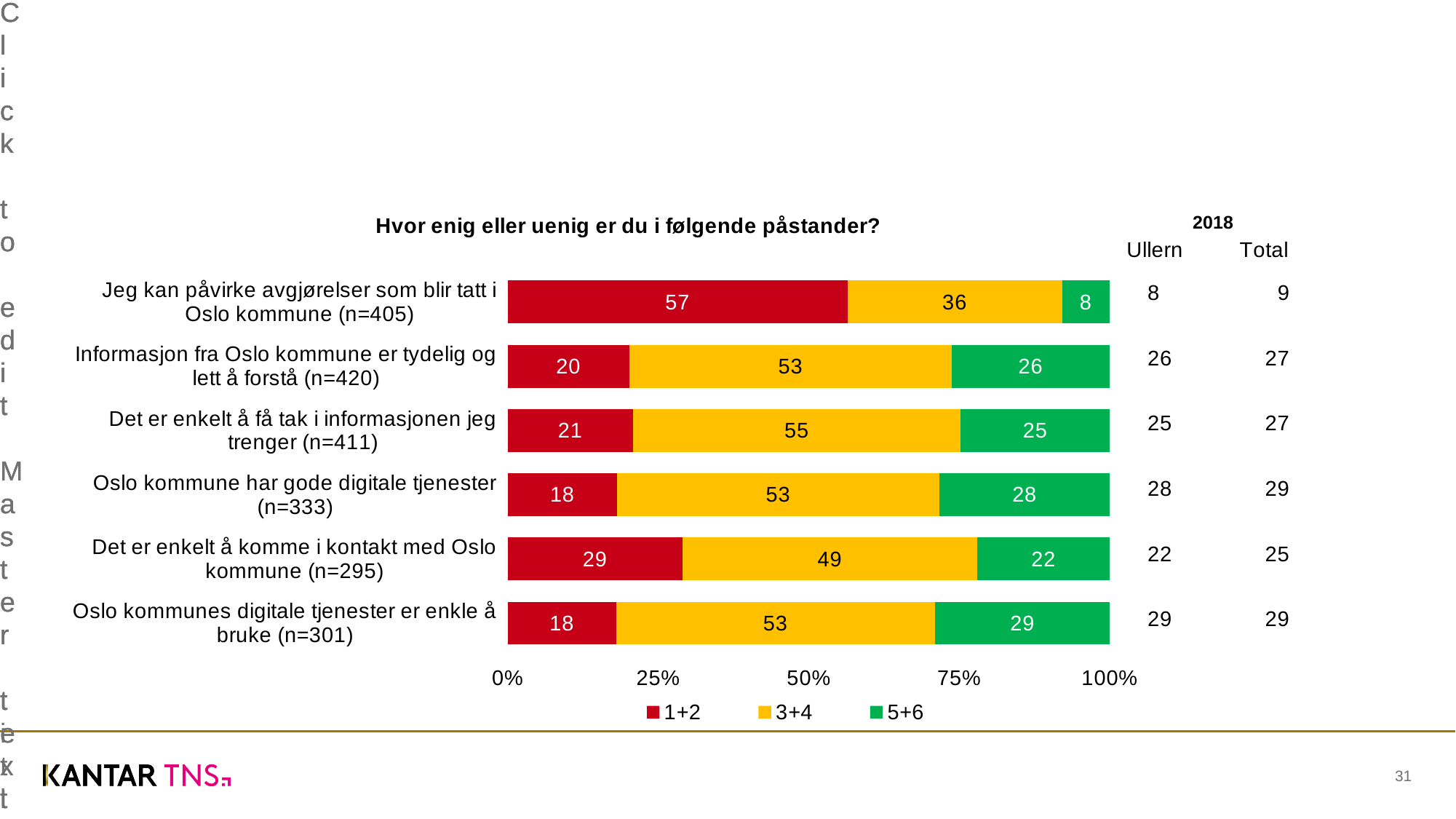
Which statement has the lowest 5+6 value? Jeg kan påvirke avgjørelser som blir tatt i Oslo kommune (n=405) Which is larger: the 5+6 value for "Informasjon fra Oslo kommune er tydelig og lett å forstå (n=420)" or the 5+6 value for "Det er enkelt å komme i kontakt med Oslo kommune (n=295)"? Informasjon fra Oslo kommune er tydelig og lett å forstå (n=420) What is the value of the 5+6 segment for "Oslo kommunes digitale tjenester er enkle å bruke (n=301)"? 29 What kind of chart is shown on the slide? Stacked bar chart What is the value of the 3+4 segment for "Det er enkelt å få tak i informasjonen jeg trenger (n=411)"? 55 What is the title of the chart? Hvor enig eller uenig er du i følgende påstander? What is the difference between the 1+2 values for "Det er enkelt å komme i kontakt med Oslo kommune (n=295)" and "Oslo kommune har gode digitale tjenester (n=333)"? 11 How many series does the legend list? 3 What is the value of the 1+2 segment for "Jeg kan påvirke avgjørelser som blir tatt i Oslo kommune (n=405)"? 57 How many statements (categories) are plotted in the chart? 6 What is the total of the stacked bar for "Det er enkelt å komme i kontakt med Oslo kommune (n=295)"? 100 Which statement has the highest 1+2 value? Jeg kan påvirke avgjørelser som blir tatt i Oslo kommune (n=405)